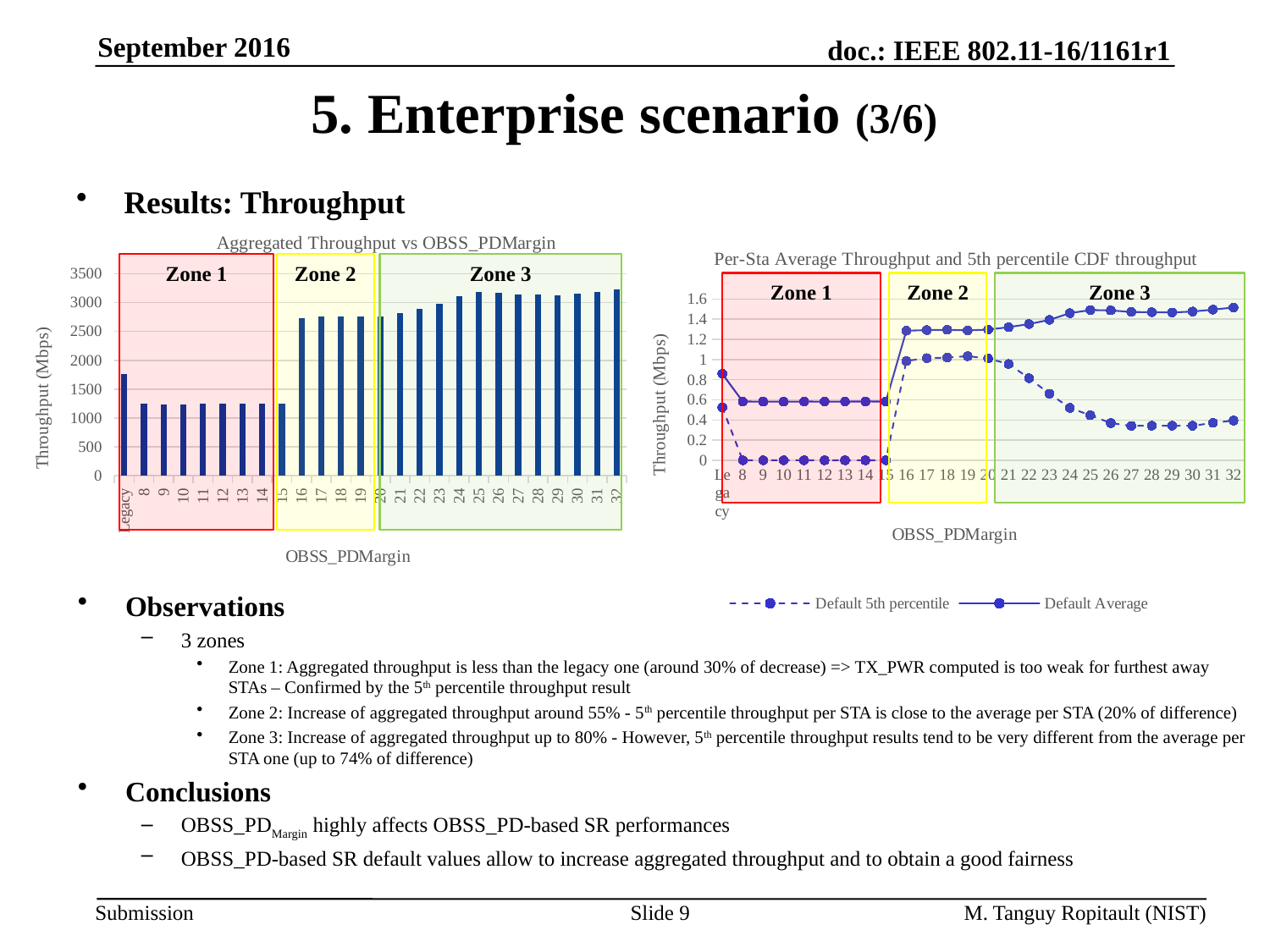
In the left chart, is the value for OBSS_PDMargin 32 greater or less than 3000? greater In the left chart, how many categories are shown on the x axis? 26 In the right chart, does the Default 5th percentile series rise or fall from OBSS_PDMargin 20 to 30? fall In the left chart, is the value for Legacy greater or less than 1500? greater In the right chart, at OBSS_PDMargin 32, which series has the larger value, Default Average or Default 5th percentile? Default Average What kind of chart is the 'Per-Sta Average Throughput and 5th percentile CDF throughput' chart on the right? line chart In the right chart, is the Default Average value at OBSS_PDMargin 16 greater or less than 1.2? greater In the left chart, which has the larger aggregated throughput, OBSS_PDMargin 15 or 16? 16 In the right chart, how many series does the legend list? 2 What kind of chart is the 'Aggregated Throughput vs OBSS_PDMargin' chart on the left? bar chart